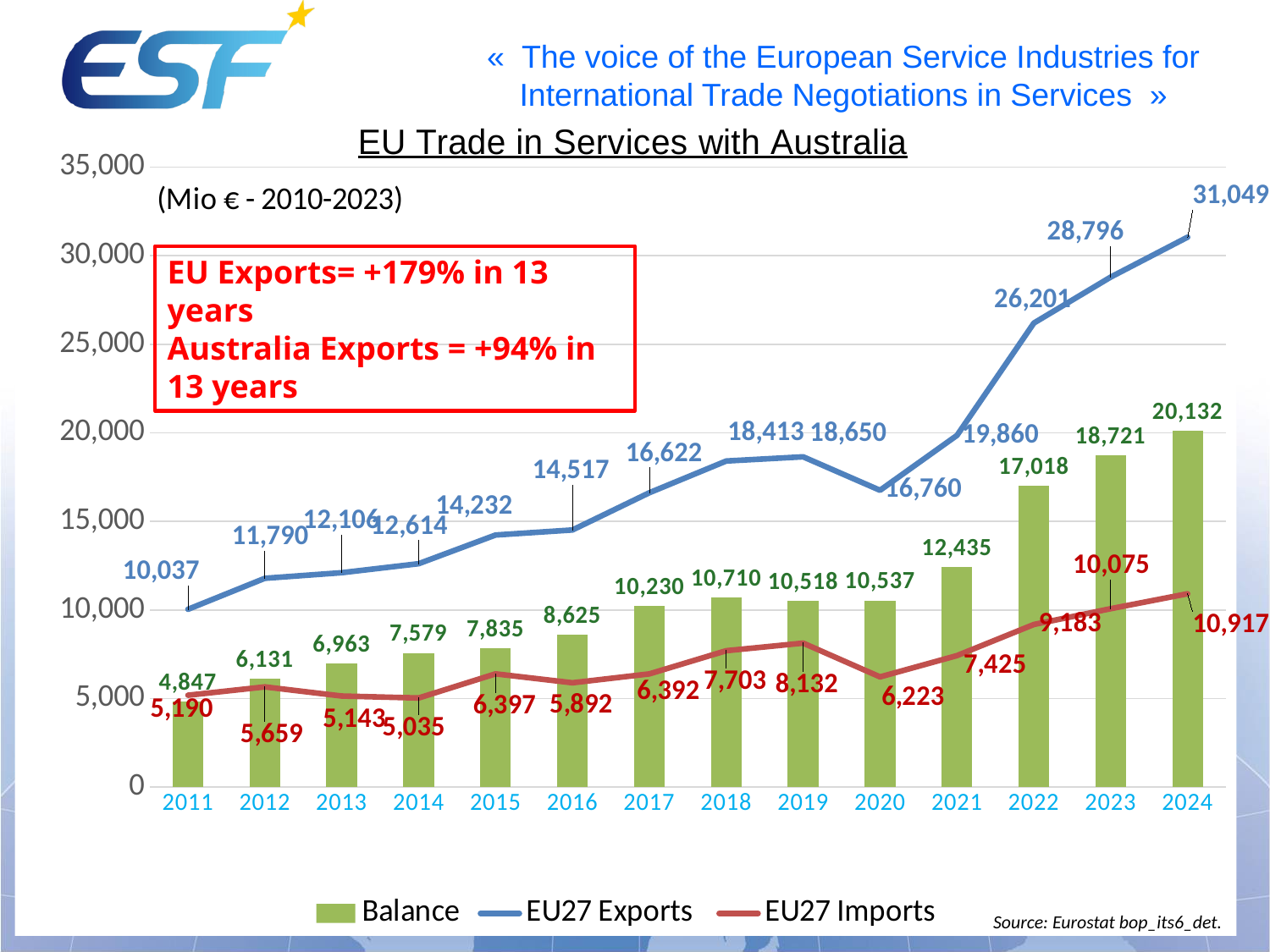
What is the value of EU27 Exports in 2024? 31,049 What kind of chart is this? Combined bar and line chart In which year is the Balance highest? 2024 What is the value of EU27 Imports in 2020? 6,223 What is the Balance value for 2017? 10,230 In which year is EU27 Imports at its lowest? 2014 Which series is drawn as green bars? Balance Which is larger: EU27 Imports in 2019 or EU27 Imports in 2021? EU27 Imports in 2019 In which year is EU27 Exports at its lowest? 2011 What is the difference between EU27 Exports in 2024 and in 2023? 2,253 How many series does the legend list? 3 How many years are shown on the x axis? 14